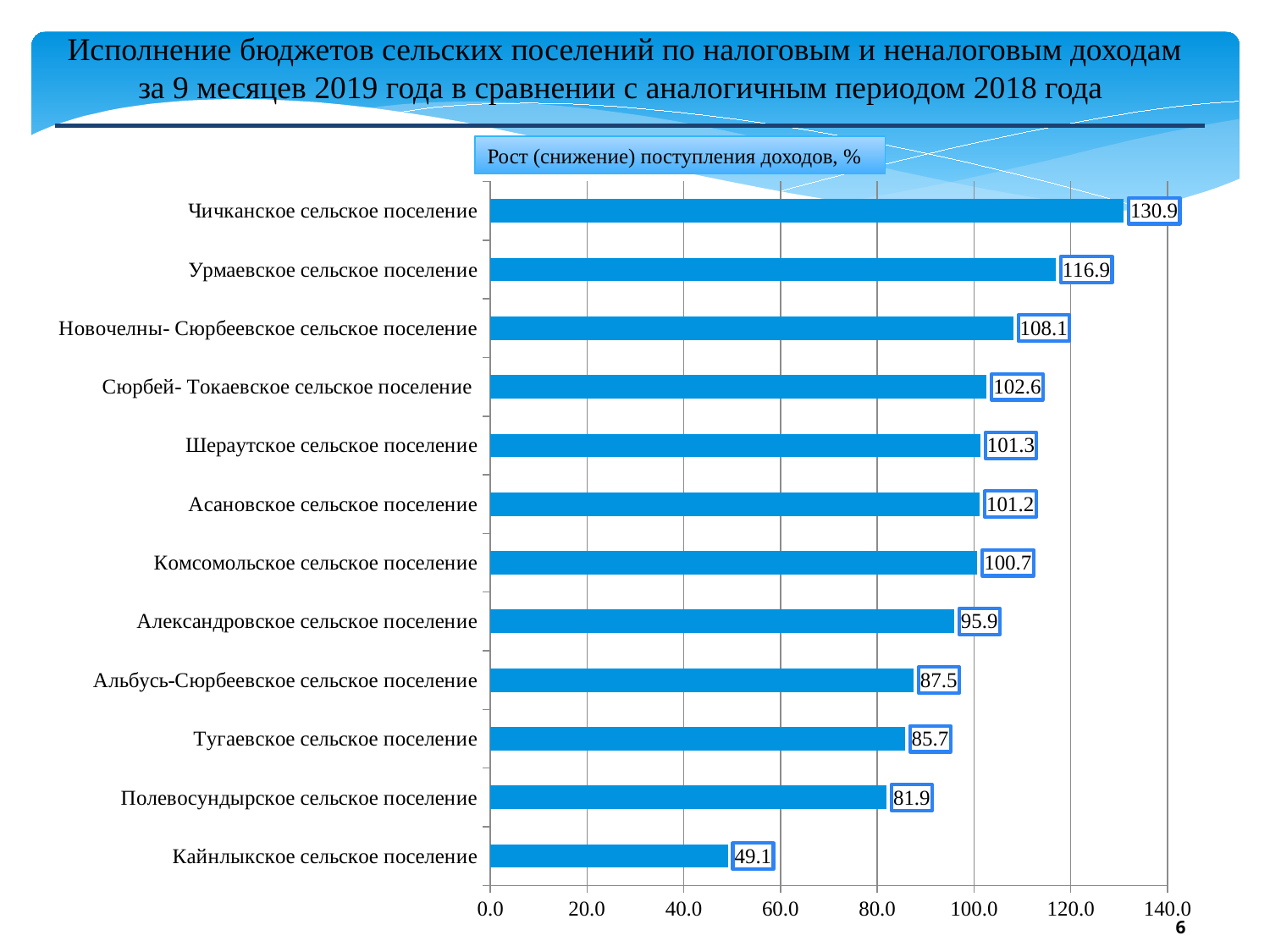
What is the title of the chart? Рост (снижение) поступления доходов, % What is the difference between the values for Чичканское сельское поселение and Кайнлыкское сельское поселение? 81.8 What is the value for Чичканское сельское поселение? 130.9 Is the value for Александровское сельское поселение greater or less than 100.0? less Which settlement has the highest value? Чичканское сельское поселение What is the value for Комсомольское сельское поселение? 100.7 Which is larger, the value for Тугаевское сельское поселение or Полевосундырское сельское поселение? Тугаевское сельское поселение What is the difference between the values for Урмаевское сельское поселение and Новочелны- Сюрбеевское сельское поселение? 8.8 What kind of chart is shown on the slide? bar chart What is the value for Кайнлыкское сельское поселение? 49.1 How many settlements are shown in the chart? 12 Which settlement has the lowest value? Кайнлыкское сельское поселение